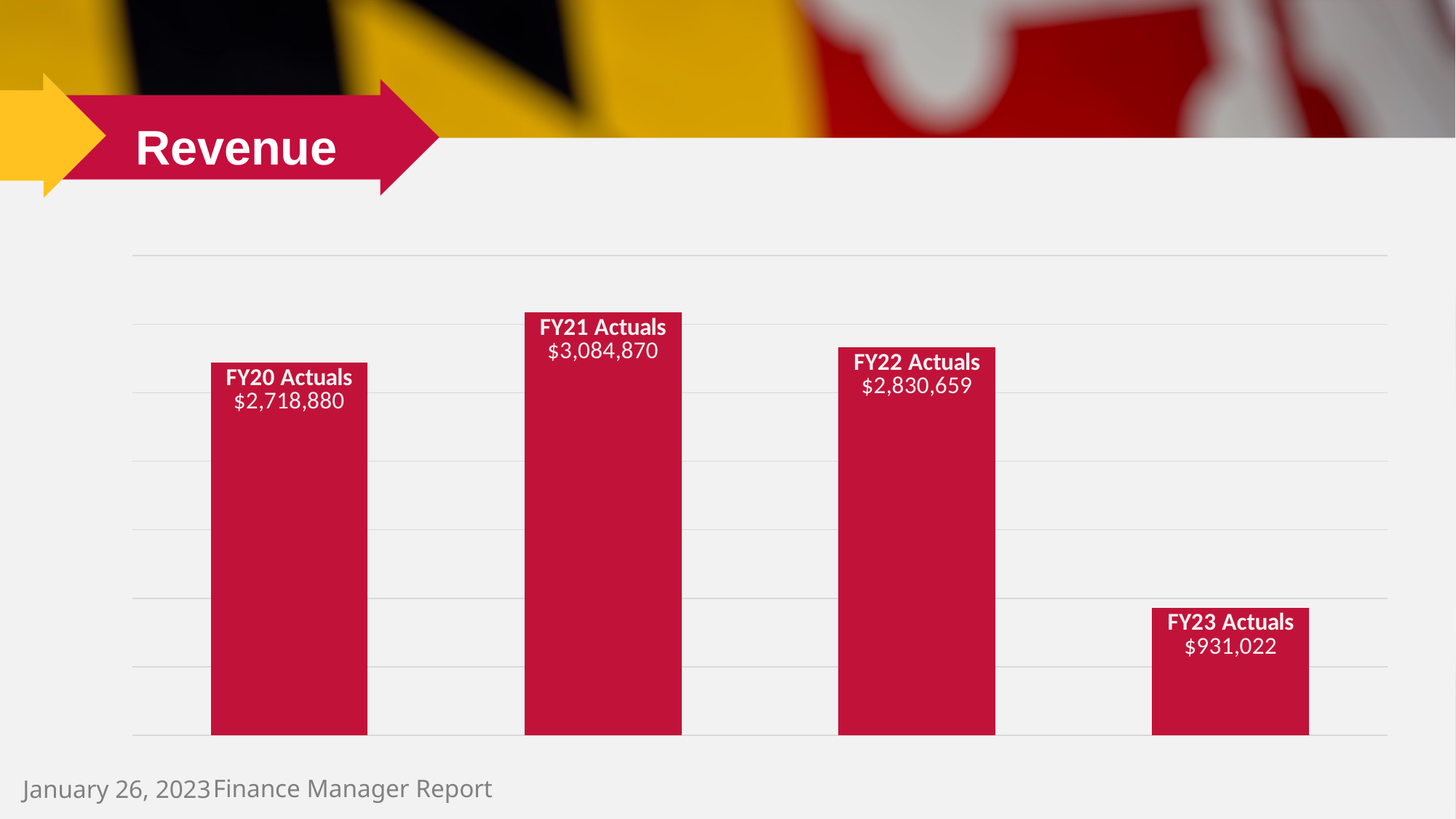
Which fiscal year has the lowest revenue? FY23 Actuals Does revenue rise or fall from FY22 Actuals to FY23 Actuals? Fall What is the value for FY23 Actuals? $931,022 What kind of chart is shown on the slide? Bar chart What is the value for FY22 Actuals? $2,830,659 Which is larger, FY20 Actuals or FY22 Actuals? FY22 Actuals What is the value for FY20 Actuals? $2,718,880 What is the difference between FY22 Actuals and FY23 Actuals? $1,899,637 Which fiscal year has the highest revenue? FY21 Actuals How many bars are shown in the chart? 4 What is the difference between FY21 Actuals and FY20 Actuals? $365,990 What is the value for FY21 Actuals? $3,084,870